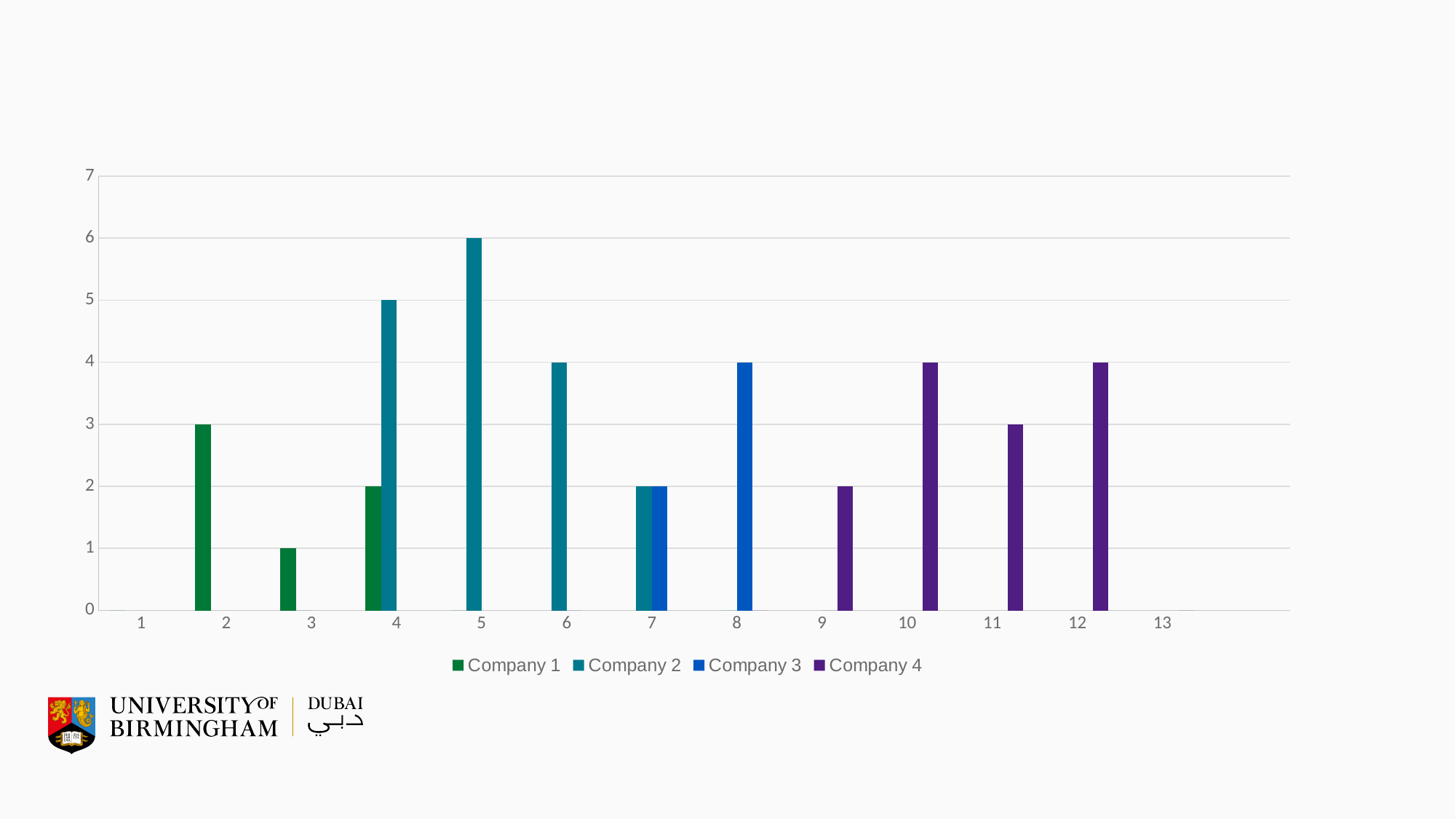
Which series is shown in purple in the legend? Company 4 What is the value of Company 1 at category 2? 3 What is the difference between Company 2's value at category 4 and Company 1's value at category 4? 3 How many categories are labelled on the x axis? 13 What is the value of Company 3 at category 8? 4 Which category has the tallest bar in the chart? 5 What is the value of Company 4 at category 11? 3 Which is larger: Company 4's value at category 10 or Company 4's value at category 9? category 10 What kind of chart is shown on the slide? bar chart How many series does the legend list? 4 What is the value of Company 2 at category 5? 6